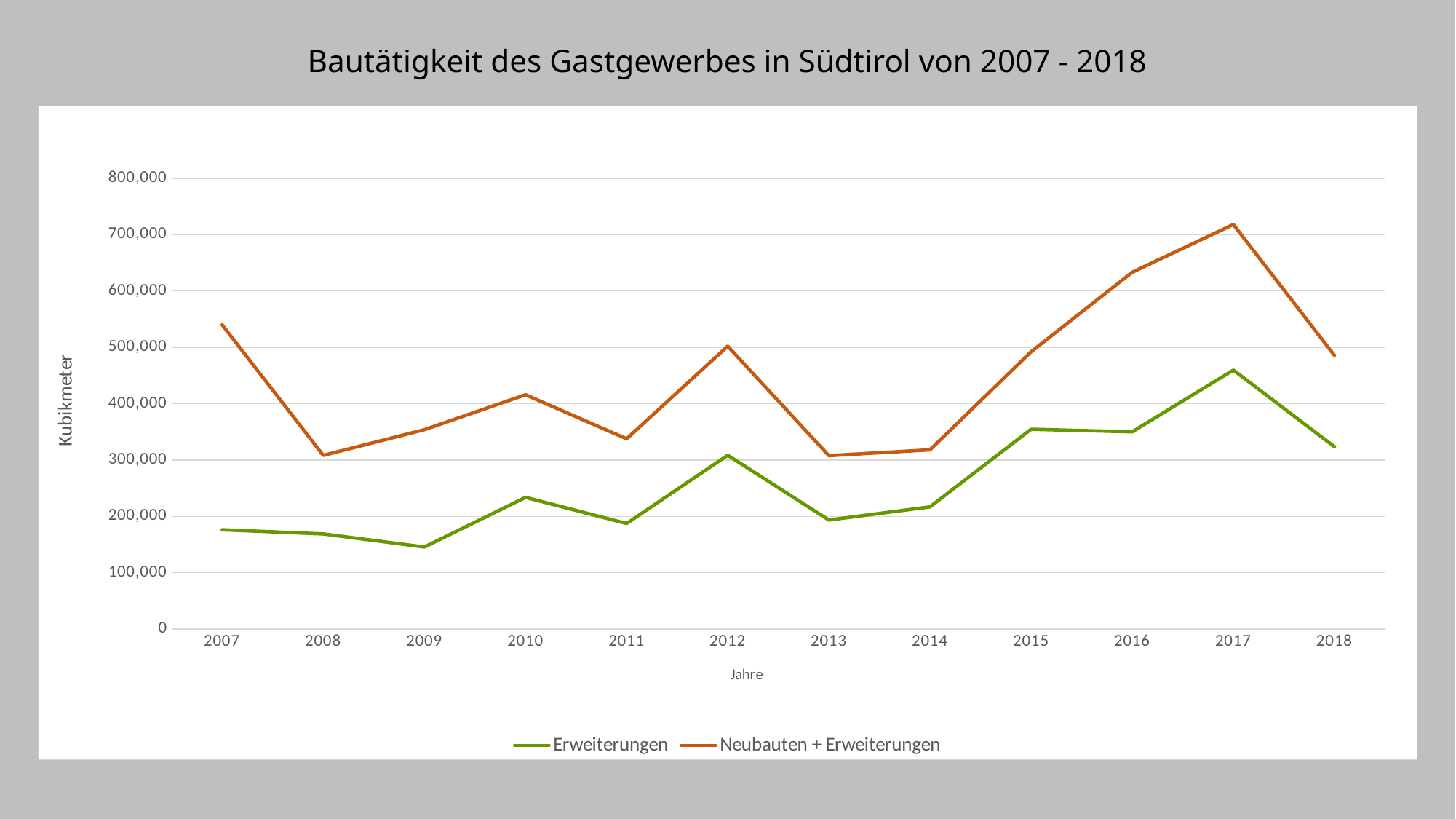
What kind of chart is shown on the slide? line chart Is the value for Neubauten + Erweiterungen in 2016 greater or less than 600,000? greater Which is larger for Neubauten + Erweiterungen: the value in 2007 or the value in 2012? 2007 What is the label of the vertical axis? Kubikmeter How many series does the legend list? 2 Is the value for Neubauten + Erweiterungen in 2007 greater or less than 500,000? greater In which year does the Erweiterungen series reach its lowest value? 2009 In which year does the Erweiterungen series reach its highest value? 2017 In which year does the Neubauten + Erweiterungen series reach its highest value? 2017 Does the Erweiterungen series rise or fall from 2014 to 2017? rise How many years are plotted along the x axis? 12 Is the value for Erweiterungen in 2009 greater or less than 200,000? less